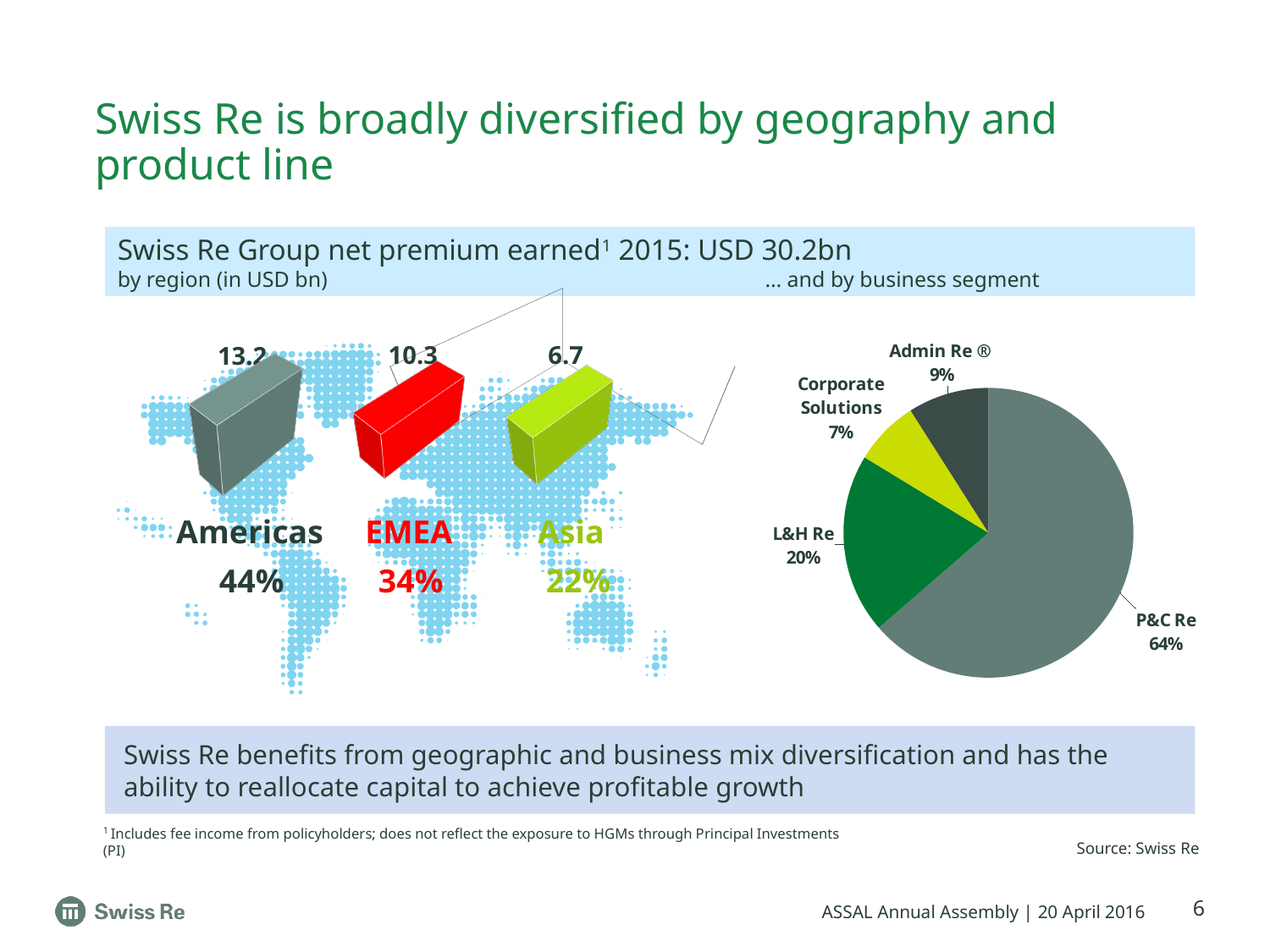
In the chart by region, what is the net premium earned for Asia in USD bn? 6.7 In the chart by region, what is the net premium earned for the Americas in USD bn? 13.2 In the pie chart by business segment, what share does P&C Re account for? 64% In the chart by region, which region has the highest net premium earned? Americas In the chart by region, what is the net premium earned for EMEA in USD bn? 10.3 In the chart by region, what is the difference in USD bn between the Americas and EMEA net premium earned? 2.9 In the pie chart by business segment, what share does L&H Re account for? 20% In the pie chart by business segment, which is larger, Admin Re or Corporate Solutions? Admin Re In the chart by region, how many regions are shown? 3 In the pie chart by business segment, which segment has the smallest share? Corporate Solutions In the chart by region, which region has the lowest net premium earned? Asia In the chart by region, what share of net premium earned does EMEA account for? 34%